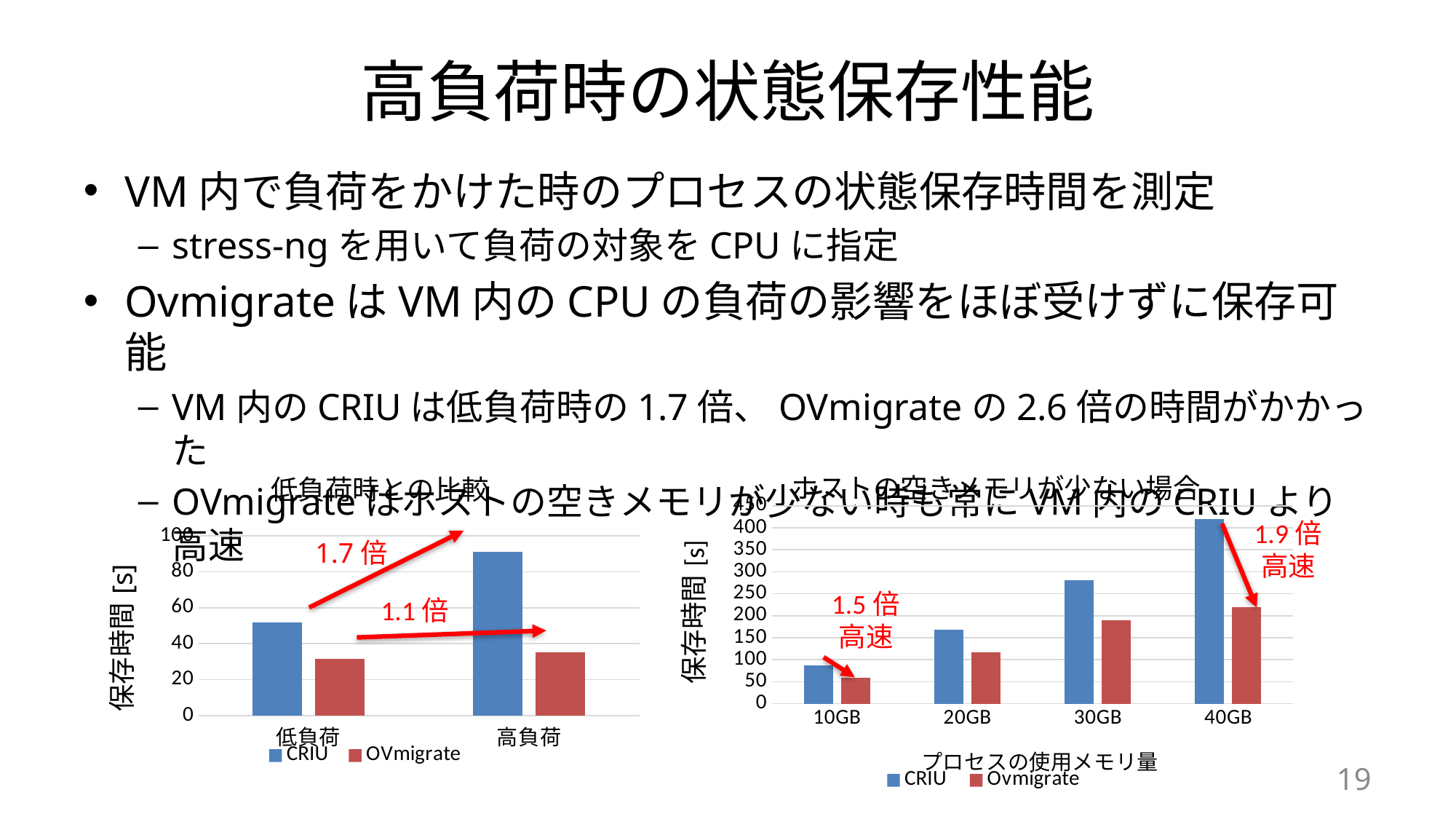
What kind of chart is the left chart on the slide? bar chart In the left chart, does the CRIU value rise or fall from 低負荷 to 高負荷? rise In the right chart, which category has the highest CRIU value? 40GB In the right chart, is the CRIU value for 40GB greater or less than 400? greater How many categories are shown on the x axis of the right chart? 4 How many series does the legend of the right chart list? 2 In the left chart, which series has the higher value for 高負荷, CRIU or OVmigrate? CRIU In the right chart, which category has the lowest Ovmigrate value? 10GB What is the x-axis title of the right chart? プロセスの使用メモリ量 In the left chart, is the CRIU value for 高負荷 greater or less than 80? greater In the left chart, is the OVmigrate value for 低負荷 greater or less than 40? less